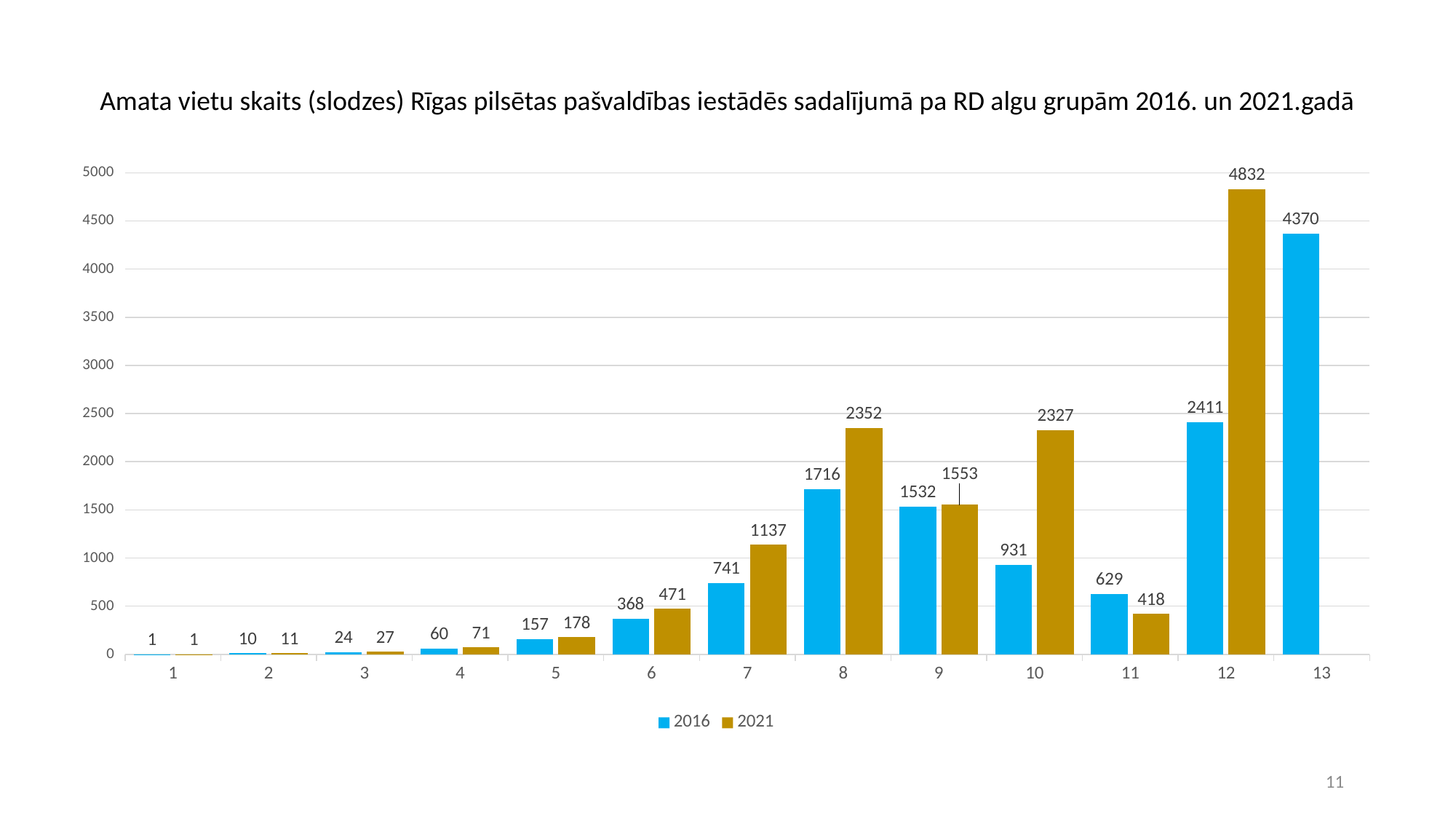
What is the 2016 value for group 13? 4370 What is the 2016 value for group 8? 1716 What is the difference between the 2016 and 2021 values for group 11? 211 What is the 2021 value for group 10? 2327 Is the 2021 value for group 7 greater or less than 1000? greater How many series does the legend list? 2 Which group has the highest 2021 value? 12 How many groups are shown on the x axis? 13 Which group has the lowest 2016 value? 1 For group 11, which year has the larger value, 2016 or 2021? 2016 What kind of chart is shown on the slide? bar chart What is the difference between the 2021 and 2016 values for group 12? 2421